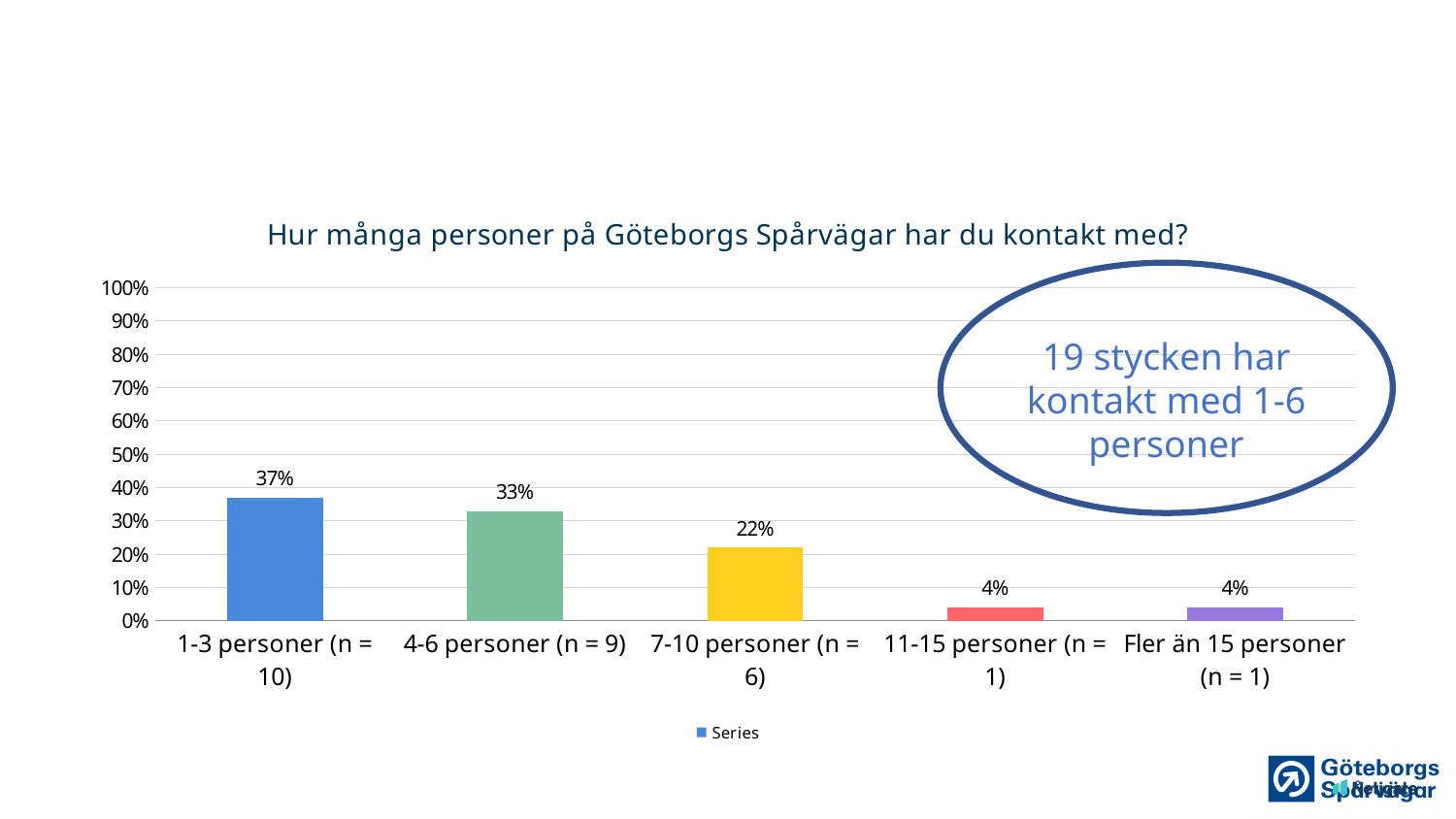
What kind of chart is shown on the slide? Bar chart Which is larger, the value for "7-10 personer (n = 6)" or the value for "Fler än 15 personer (n = 1)"? 7-10 personer (n = 6) What is the value for "11-15 personer (n = 1)"? 4% How many categories are shown on the x axis? 5 What is the difference between the values for "4-6 personer (n = 9)" and "7-10 personer (n = 6)"? 11% Which category has the highest value? 1-3 personer (n = 10) What is the value for "4-6 personer (n = 9)"? 33% What is the difference between the values for "1-3 personer (n = 10)" and "4-6 personer (n = 9)"? 4% Do the values rise or fall from left to right along the x axis? Fall What is the title of the chart? Hur många personer på Göteborgs Spårvägar har du kontakt med? What is the value for "7-10 personer (n = 6)"? 22% What is the value for "1-3 personer (n = 10)"? 37%